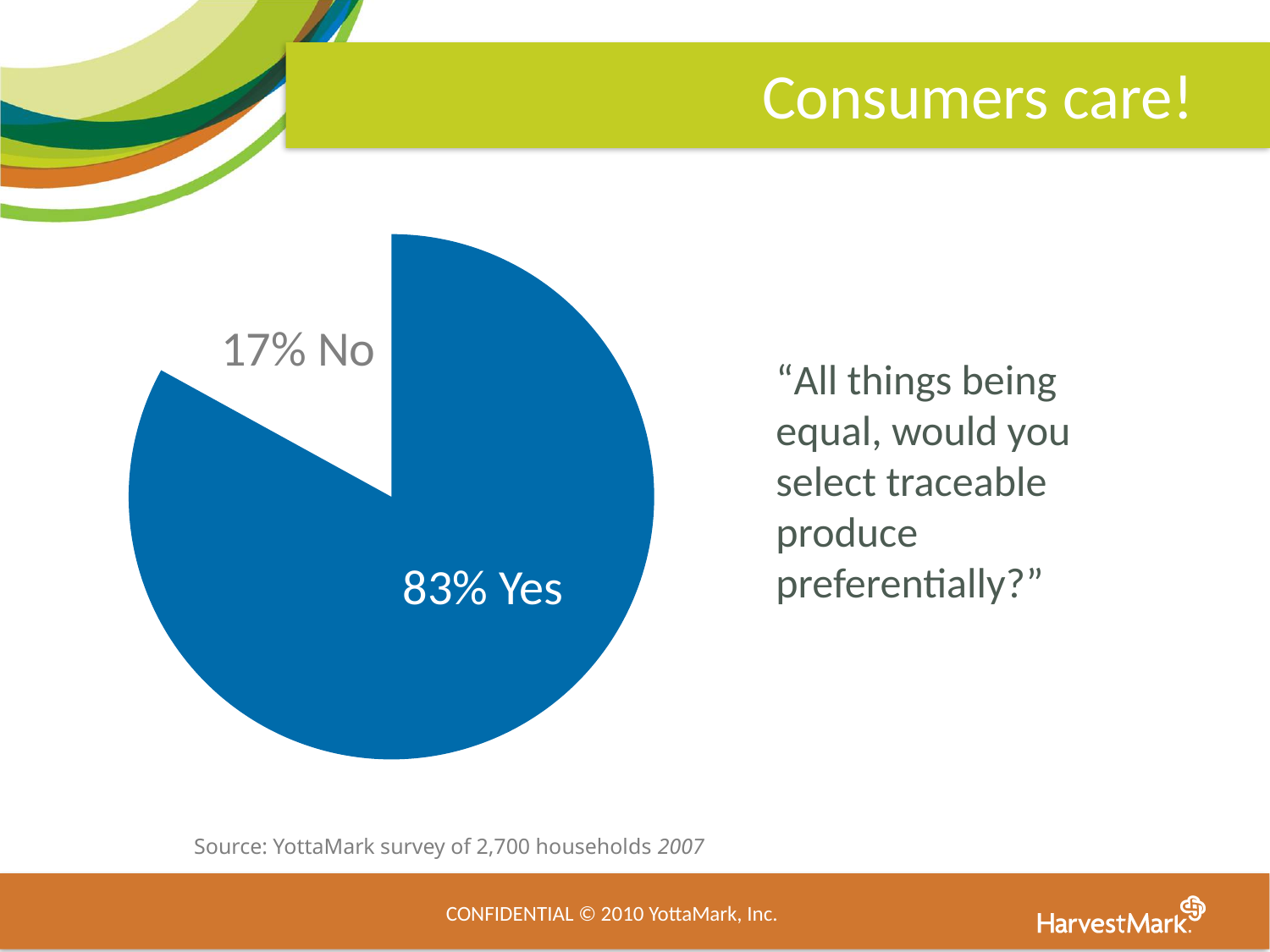
What kind of chart is shown on the slide? pie chart Which response has the smallest slice of the pie? No How many percentage points larger is the Yes share than the No share? 66 Is the Yes share greater or less than 50%? greater What share of respondents answered No? 17% Which response has the largest slice of the pie? Yes What is the title of the slide containing the pie chart? Consumers care! How many slices does the pie chart have? 2 What colour is the Yes slice of the pie? blue What is the combined share of the Yes and No slices? 100% Which is larger, the Yes share or the No share? Yes What share of respondents answered Yes? 83%